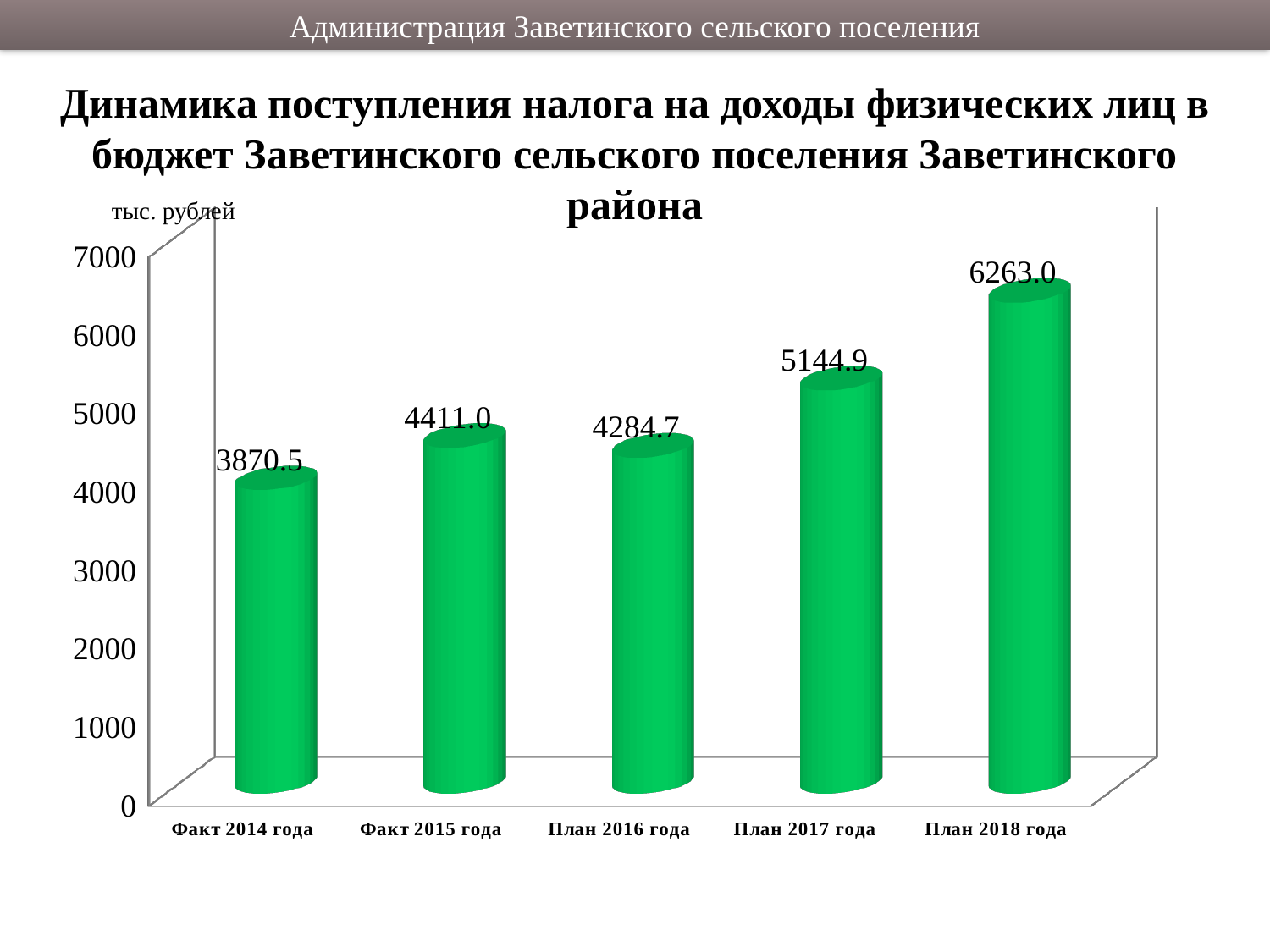
What is the difference between the values for План 2018 года and Факт 2014 года? 2392.5 How many categories are shown on the x axis? 5 What unit is indicated above the vertical axis? тыс. рублей Is the value for План 2018 года greater or less than 6000? greater What is the difference between the values for Факт 2015 года and План 2016 года? 126.3 Which is larger, the value for Факт 2015 года or the value for План 2016 года? Факт 2015 года Which category has the lowest value? Факт 2014 года Which category has the highest value? План 2018 года What kind of chart is shown on the slide? bar chart What is the value for План 2017 года? 5144.9 What is the value for Факт 2014 года? 3870.5 What is the value for План 2016 года? 4284.7